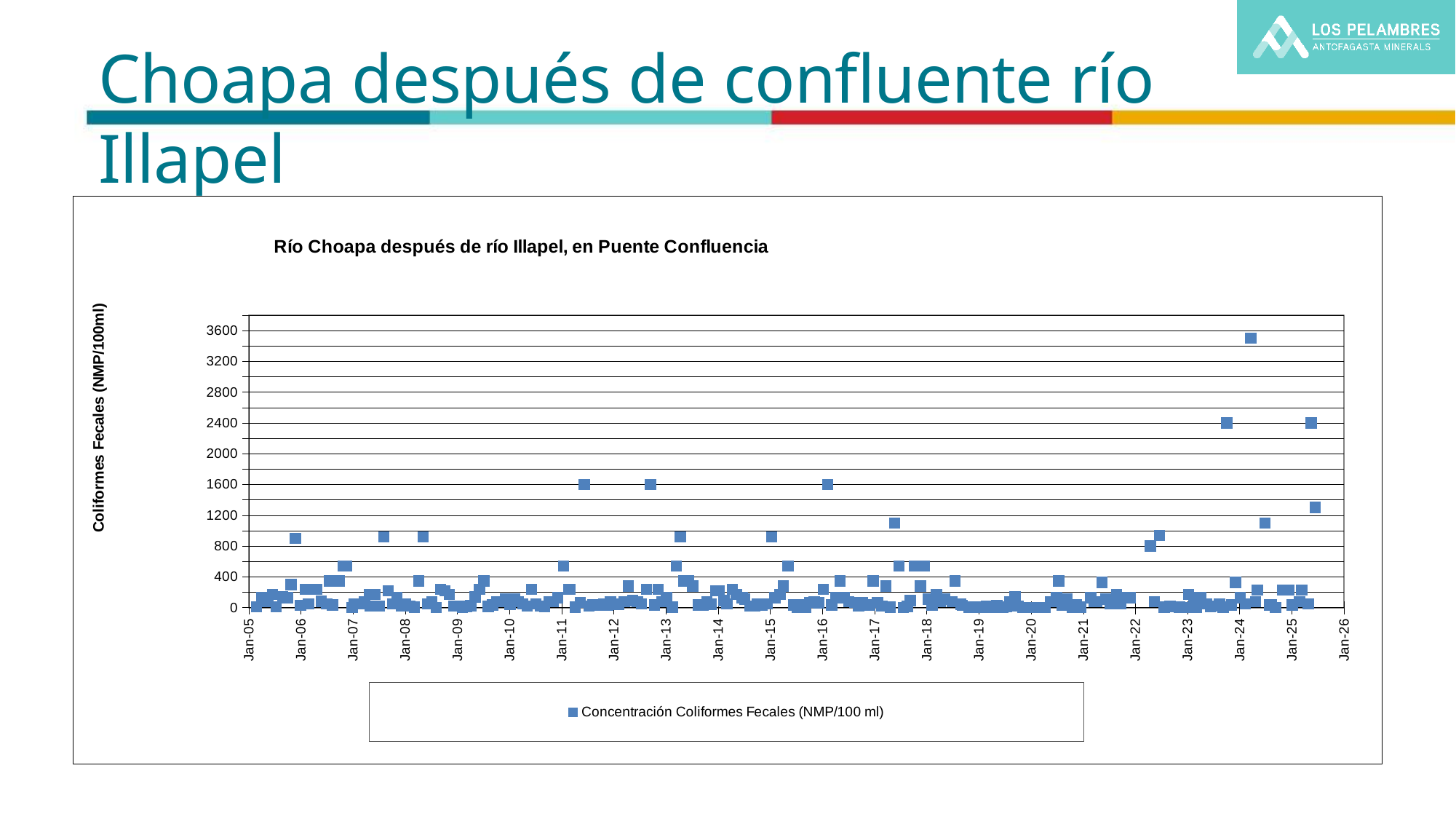
How many series does the legend list? 1 How many plotted points have a value greater than 2000? 3 Is the highest plotted value on the chart greater or less than 3200? greater What is the title of the chart? Río Choapa después de río Illapel, en Puente Confluencia What kind of chart is shown on the slide? scatter chart Is the highest point between Jan-11 and Jan-12 greater or less than 2000? less Is the highest point between Jan-11 and Jan-12 greater or less than 1200? greater What is the legend entry for the plotted series? Concentración Coliformes Fecales (NMP/100 ml) Which is larger: the highest point near Jan-24 or the highest point near Jan-16? the highest point near Jan-24 How many plotted points have a value greater than 2800? 1 In which year does the highest plotted value occur? 2024